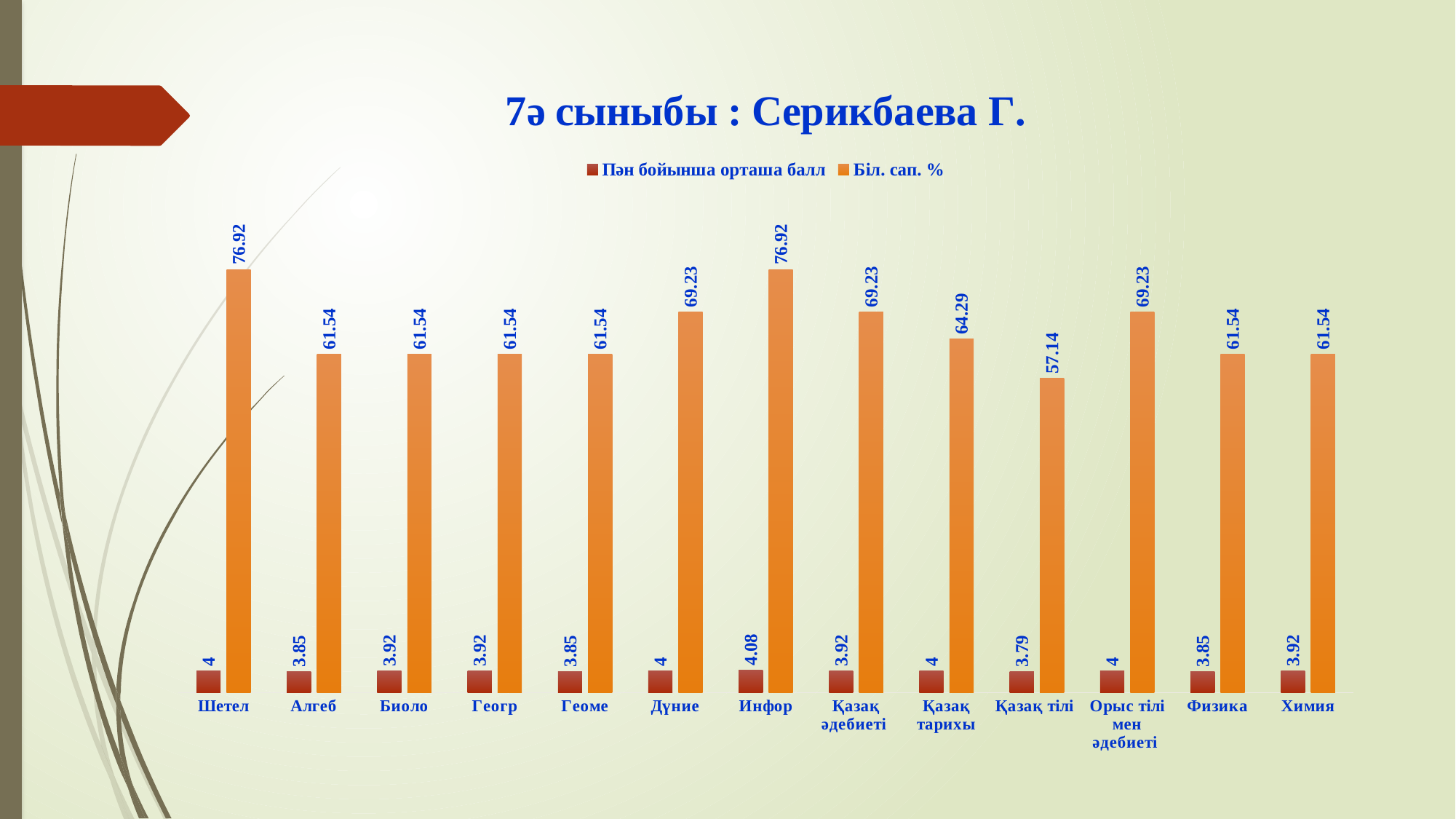
Which subject has the lowest "Пән бойынша орташа балл" value? Қазақ тілі How many series does the legend list? 2 What is the value of "Біл. сап. %" for Қазақ тарихы? 64.29 Which has a larger "Біл. сап. %" value, Дүние or Физика? Дүние Which subject has the lowest "Біл. сап. %" value? Қазақ тілі What is the value of "Біл. сап. %" for Шетел? 76.92 How many subjects (categories) are shown on the x axis? 13 What type of chart is shown on the slide? bar chart What is the difference between the "Біл. сап. %" values for Шетел and Алгеб? 15.38 Which subject has the highest "Пән бойынша орташа балл" value? Инфор What is the title of the chart? 7ә сыныбы : Серикбаева Г. What is the value of "Пән бойынша орташа балл" for Инфор? 4.08